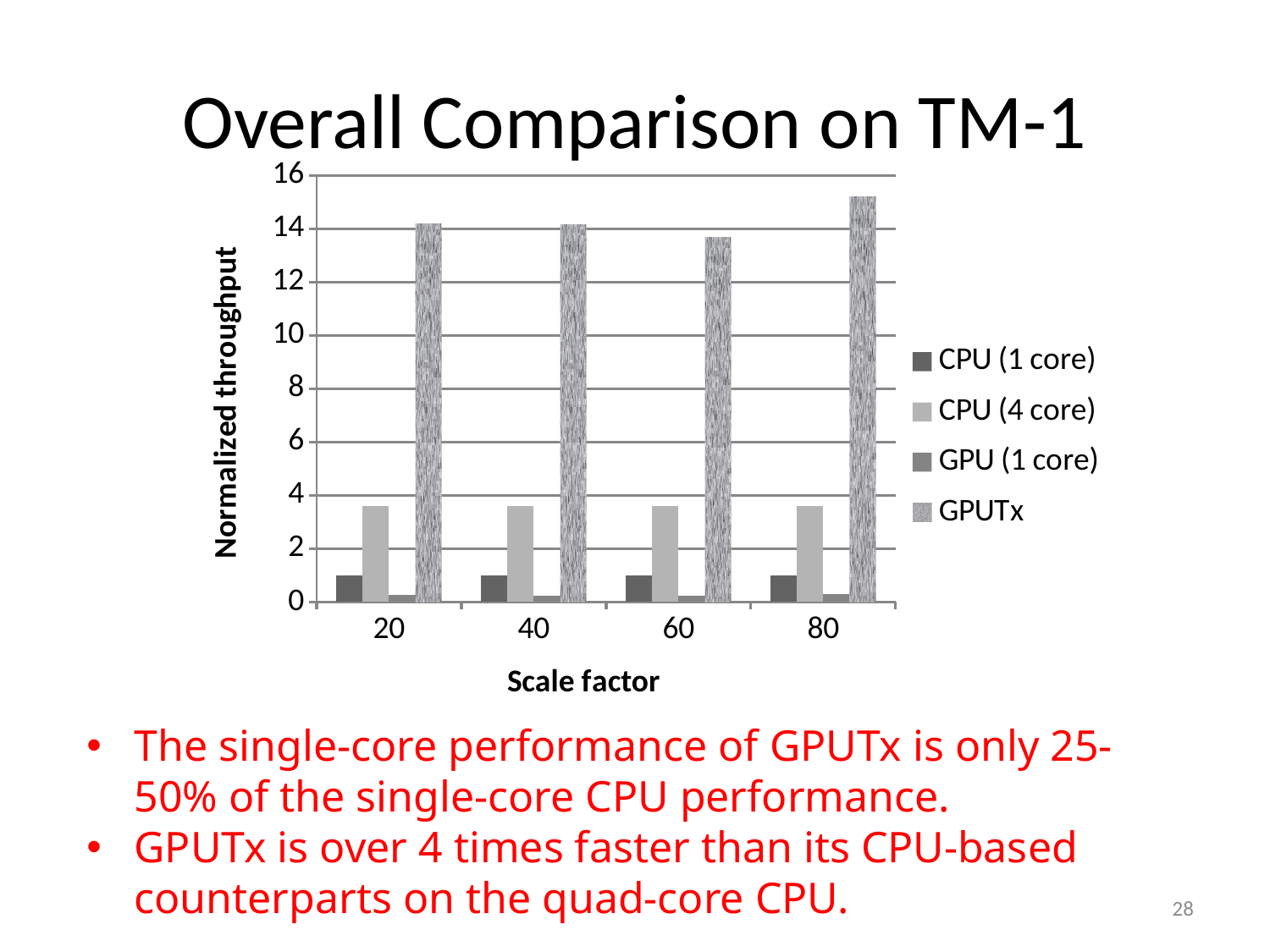
What is the title of the y axis? Normalized throughput Is the value for CPU (1 core) at scale factor 60 greater or less than 2? less Which series has the highest value at scale factor 20? GPUTx Is the value for CPU (4 core) at scale factor 20 greater or less than 4? less Is the value for GPUTx at scale factor 60 greater or less than 14? less How many scale factor categories are shown on the x axis? 4 At scale factor 40, which is larger: GPUTx or CPU (4 core)? GPUTx At which scale factor is the GPUTx value highest? 80 What kind of chart is shown on the slide? bar chart Which series has the lowest value at scale factor 20? GPU (1 core) How many series does the legend list? 4